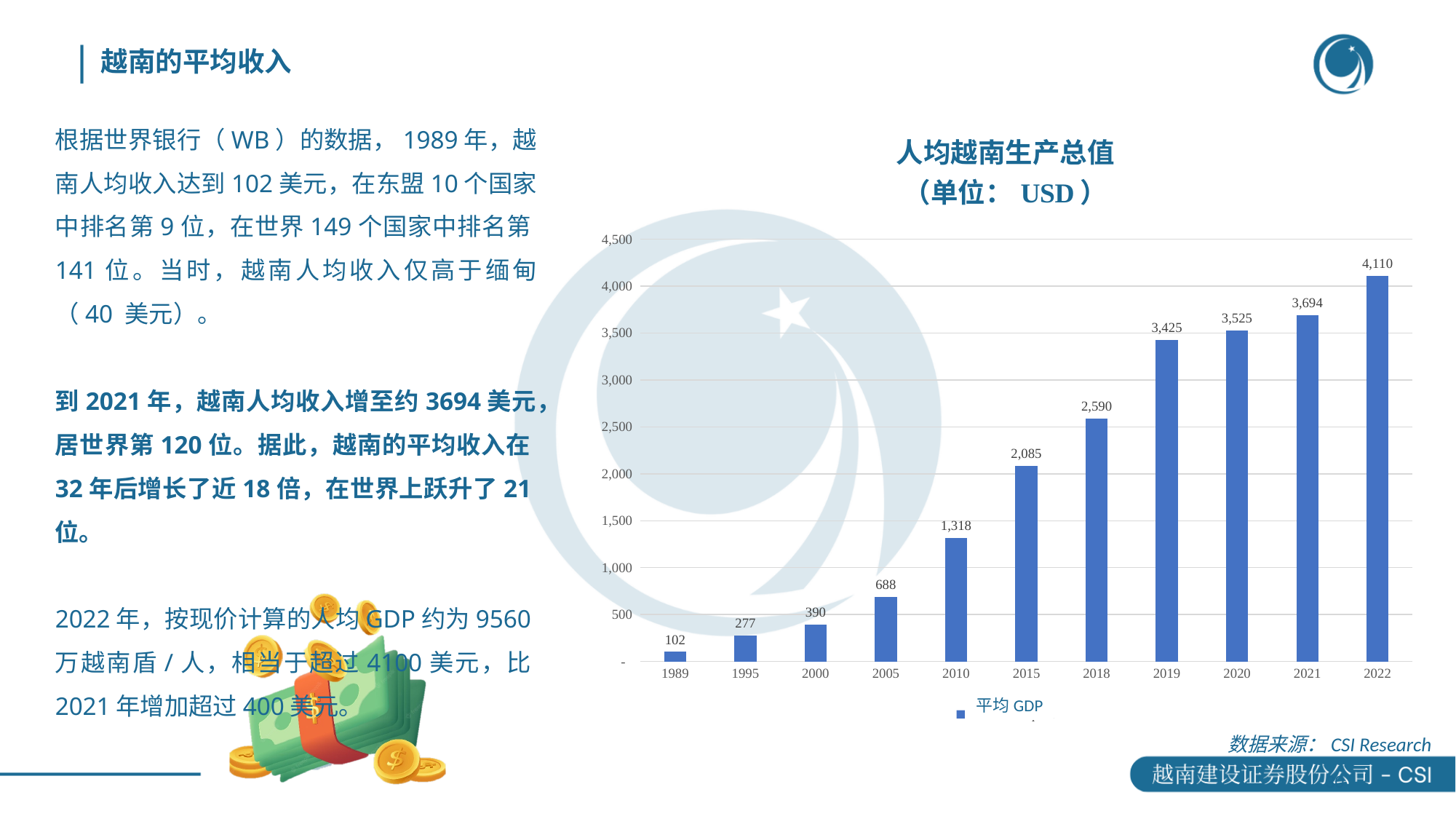
Do the values rise or fall from 1989 to 2022? rise How many series does the legend list? 1 Which year has the highest value? 2022 Is the value for 2020 greater or less than 3,000? greater What is the value for 1995? 277 Which is larger, the value for 2015 or the value for 2018? 2018 What kind of chart is this? bar chart What is the difference between the values for 2022 and 2021? 416 What is the value for 2010? 1,318 What is the value for 2019? 3,425 How many years are shown on the x axis? 11 Which year has the lowest value? 1989